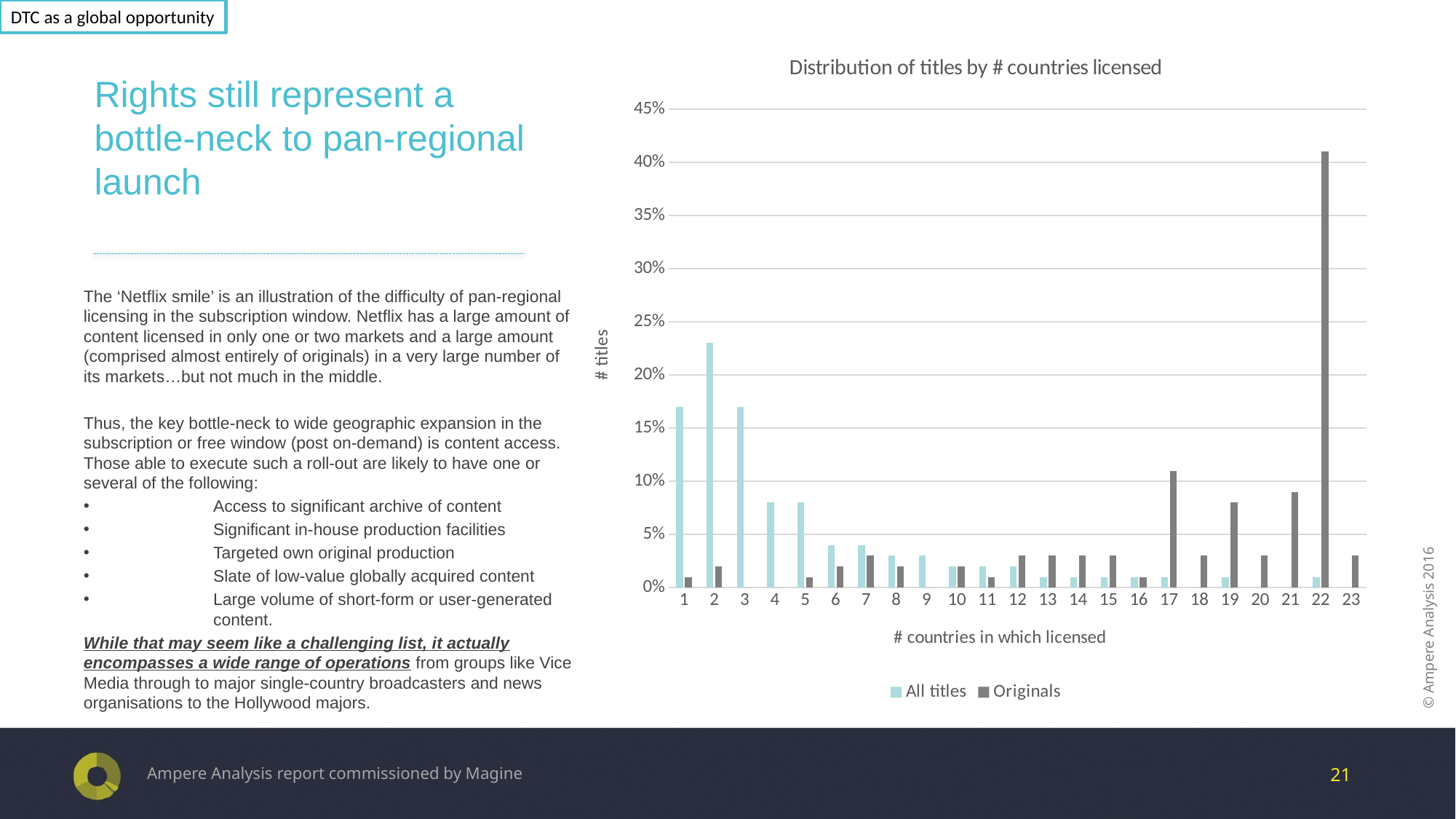
Is the All titles value for 2 countries greater or less than 20%? greater What type of chart is shown on the slide? Bar chart How many series does the legend list? 2 Is the All titles value for 1 country greater or less than 20%? less For which number of countries is the Originals value highest? 22 Which is larger: the Originals value for 22 countries or the All titles value for 2 countries? Originals for 22 countries Is the Originals value for 22 countries greater or less than 35%? greater How many categories are shown on the x axis? 23 Which is larger: the All titles value for 2 countries or the All titles value for 4 countries? 2 countries For which number of countries is the All titles value highest? 2 What is the title of the chart? Distribution of titles by # countries licensed